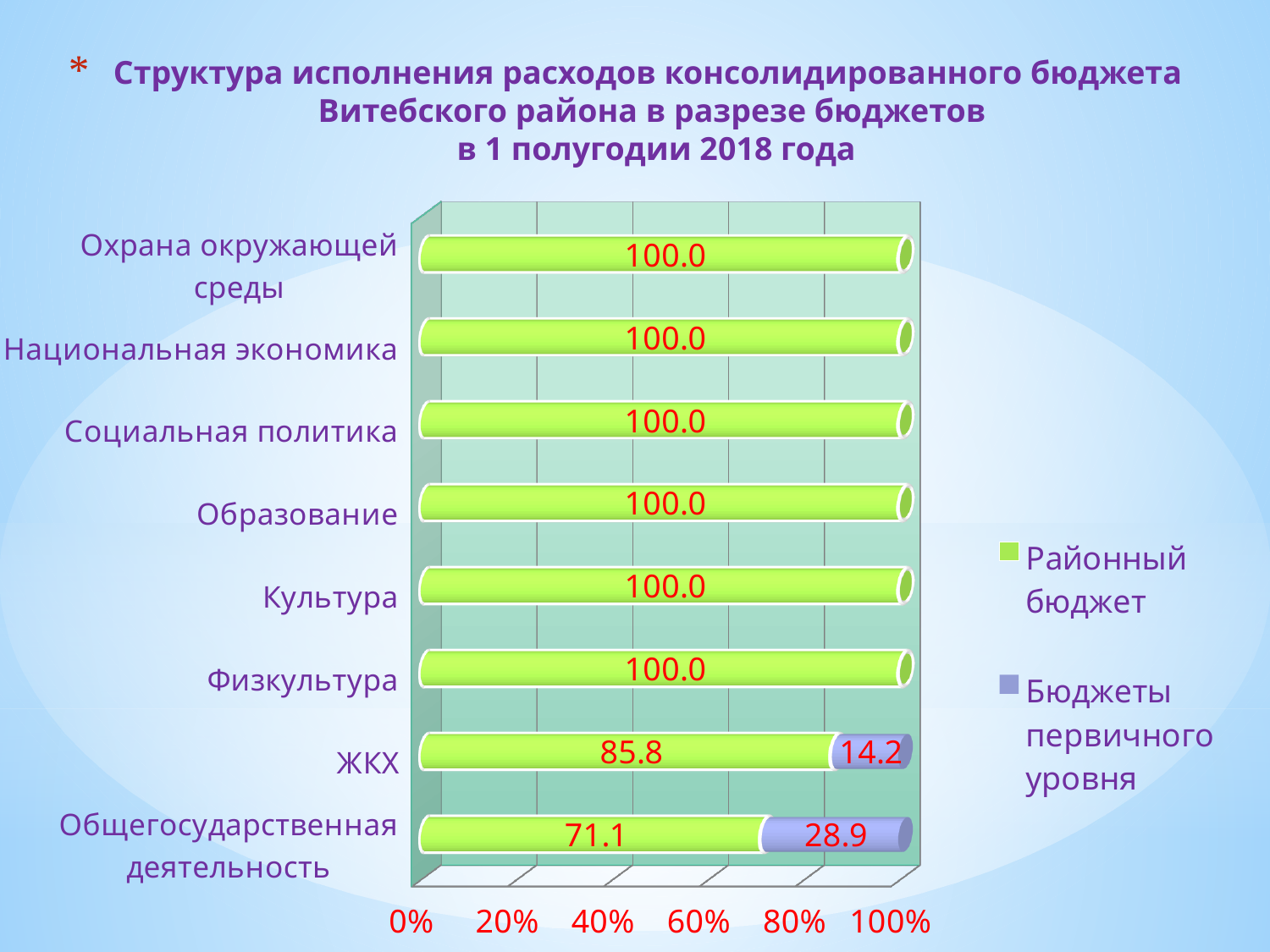
What kind of chart is shown on the slide? Stacked bar chart What is the value for Бюджеты первичного уровня for Общегосударственная деятельность? 28.9 Which is larger: the Районный бюджет value for ЖКХ or for Общегосударственная деятельность? ЖКХ How many categories are shown on the chart? 8 How many series does the legend list? 2 What is the value for Районный бюджет for ЖКХ? 85.8 What is the difference between the Районный бюджет values for ЖКХ and Общегосударственная деятельность? 14.7 Which category has the highest value for Бюджеты первичного уровня? Общегосударственная деятельность What is the value for Районный бюджет for Образование? 100.0 Which category has the lowest value for Районный бюджет? Общегосударственная деятельность What is the value for Бюджеты первичного уровня for ЖКХ? 14.2 What is the total of the stacked bar for ЖКХ? 100.0